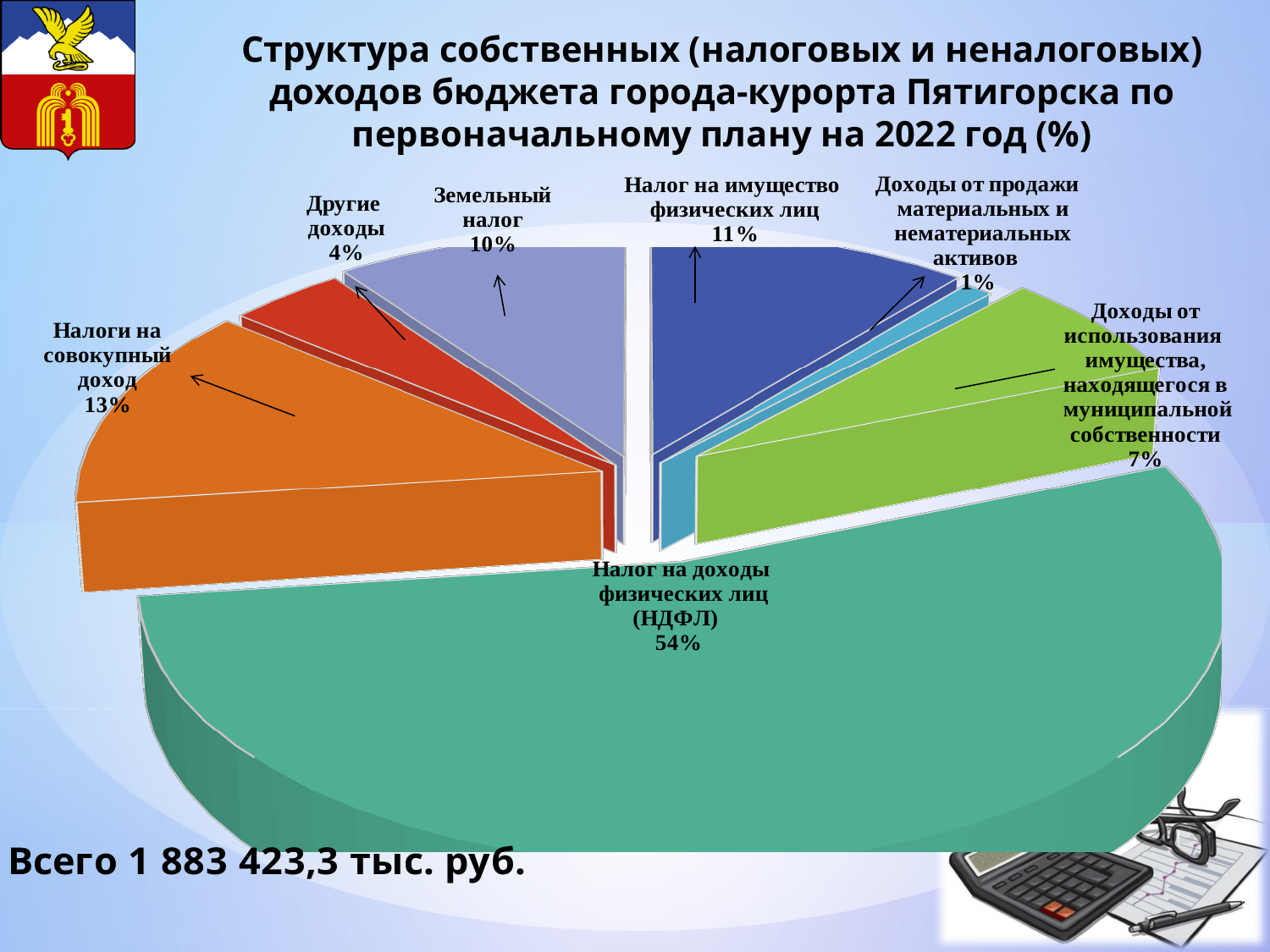
What is the difference in percentage points between «Налоги на совокупный доход» and «Другие доходы»? 9 Which is larger: the share of «Налог на имущество физических лиц» or the share of «Земельный налог»? Налог на имущество физических лиц Which category has the largest share of the pie? Налог на доходы физических лиц (НДФЛ) How many categories (slices) does the pie chart have? 7 What type of chart is shown on the slide? Pie chart What share of the budget's own revenues does «Налог на доходы физических лиц (НДФЛ)» account for? 54% What percentage is shown for «Доходы от использования имущества, находящегося в муниципальной собственности»? 7% What percentage is shown for «Налог на имущество физических лиц»? 11% What percentage is shown for «Земельный налог»? 10% Which category has the smallest share of the pie? Доходы от продажи материальных и нематериальных активов What percentage is shown for «Налоги на совокупный доход»? 13% What total amount of own revenues is stated on the slide? 1 883 423,3 тыс. руб.